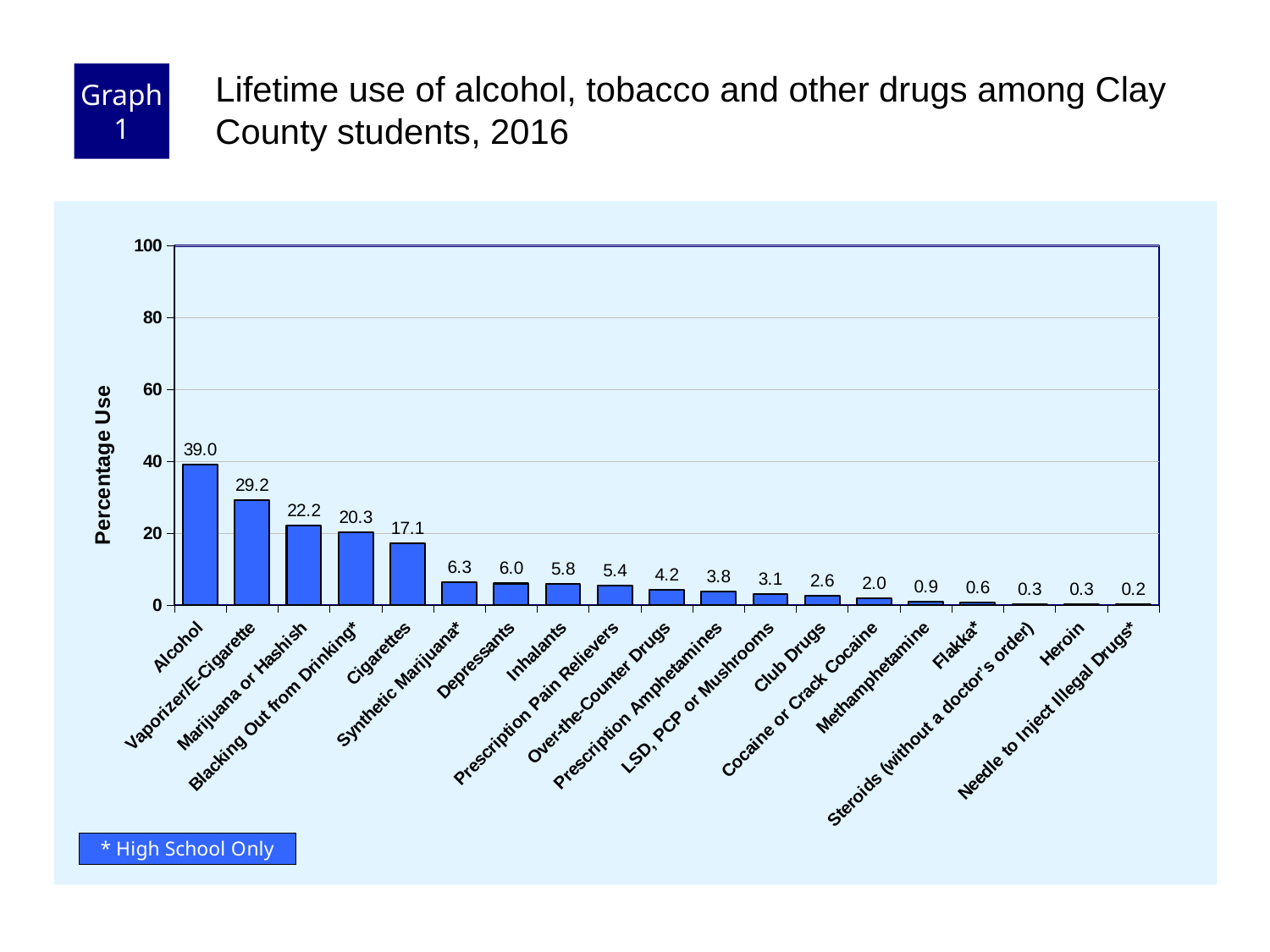
What is the percentage use for Vaporizer/E-Cigarette? 29.2 What is the percentage use for Alcohol? 39.0 Is the value for Cigarettes greater or less than 20? less What is the label of the y axis? Percentage Use What is the percentage use for Cigarettes? 17.1 What is the difference in percentage use between Alcohol and Vaporizer/E-Cigarette? 9.8 What is the percentage use for Methamphetamine? 0.9 What kind of chart is shown on the slide? Bar chart Which category has the highest percentage use? Alcohol How many categories are shown on the chart? 19 Which has a higher percentage use, Marijuana or Hashish or Blacking Out from Drinking*? Marijuana or Hashish Which category has the lowest percentage use? Needle to Inject Illegal Drugs*